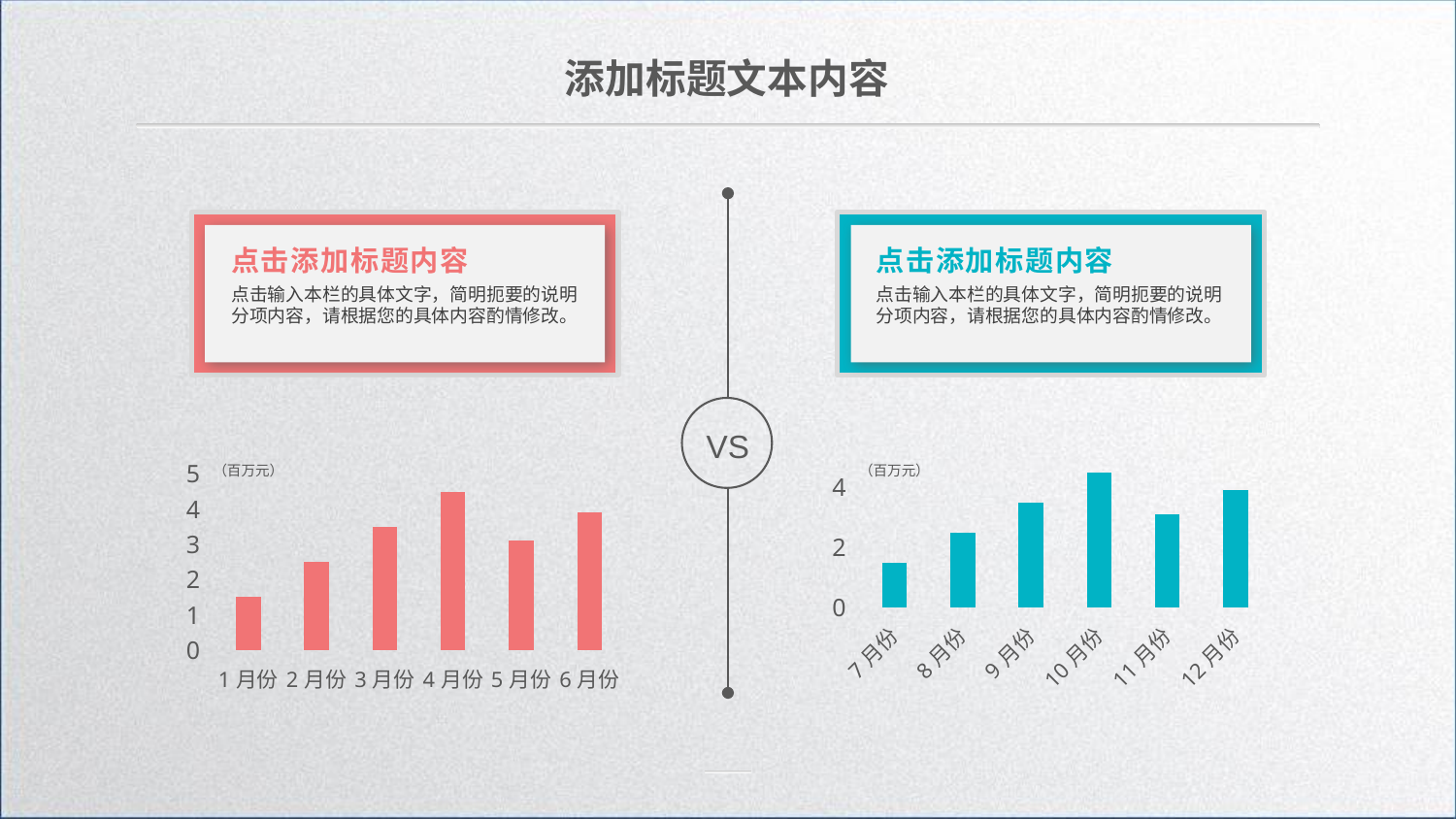
In the left chart, which is larger, the value for 3月份 or the value for 5月份? 3月份 How many categories does the right chart (7月份 to 12月份) show? 6 What unit is shown next to the y axis of the right chart? 百万元 In the right chart, is the value for 7月份 greater or less than 2? less In the left chart, is the value for 1月份 greater or less than 2? less In the left chart, which month has the lowest bar? 1月份 What kind of chart is the left chart (the red one)? bar chart In the right chart, which month has the highest bar? 10月份 How many categories does the left chart (1月份 to 6月份) show? 6 In the right chart, which month has the lowest bar? 7月份 In the left chart, which month has the highest bar? 4月份 In the left chart, is the value for 4月份 greater or less than 4? greater